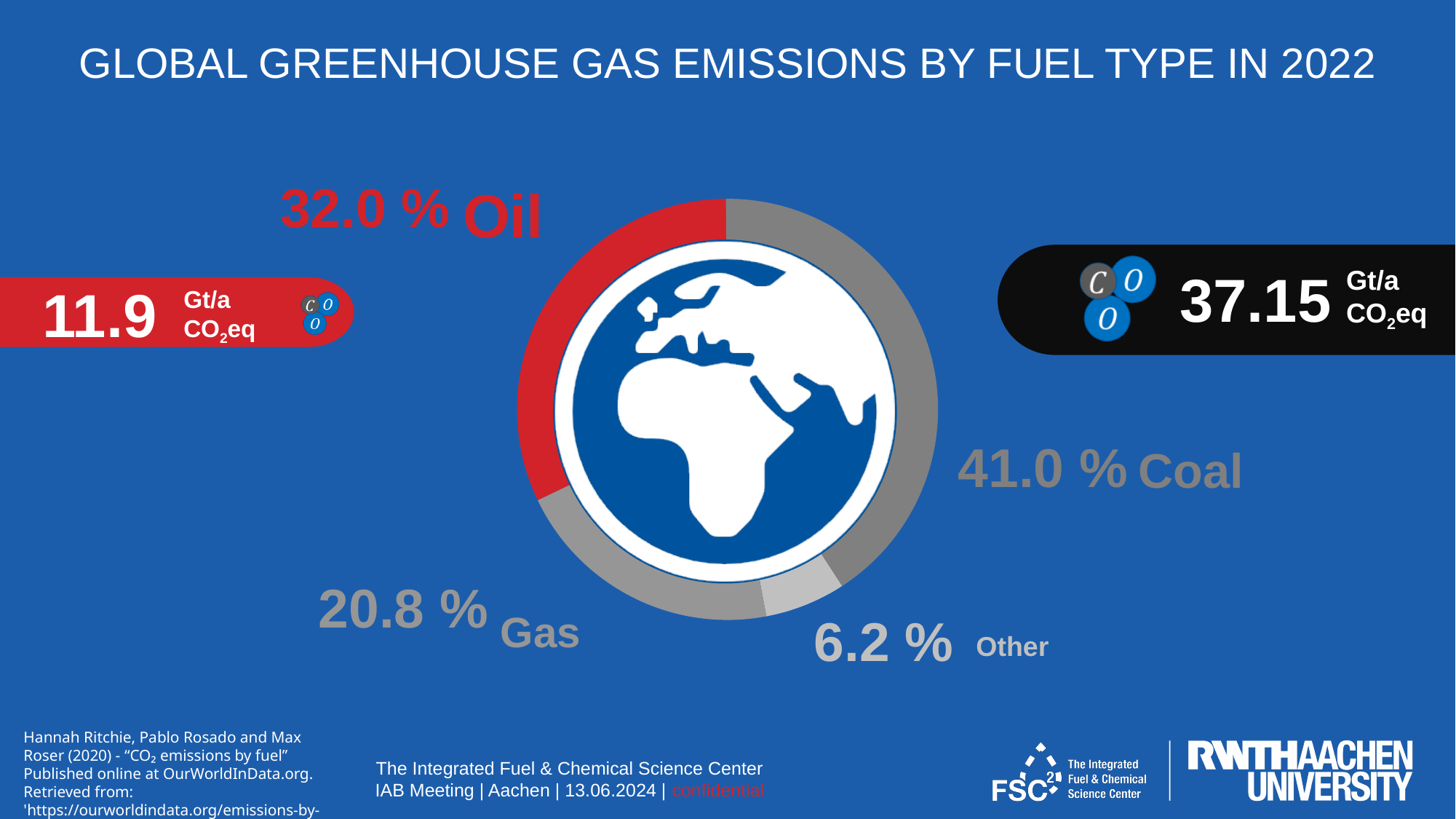
What percentage is shown for Other? 6.2 % How many percentage points larger is the Coal share than the Oil share? 9.0 % What percentage is shown for Gas? 20.8 % What share of global greenhouse gas emissions by fuel type in 2022 does Coal account for? 41.0 % What share of the donut chart is labelled Oil? 32.0 % What colour is the Oil slice of the chart? Red What total annual emissions figure is shown in the black callout on the right? 37.15 Gt/a CO2eq Which fuel type has the smallest share of emissions in the chart? Other How many fuel-type categories are shown in the chart? 4 Which fuel type has the largest share of emissions in the chart? Coal What kind of chart is used to show the emissions by fuel type? Donut (pie) chart Which has a larger share, Gas or Oil? Oil